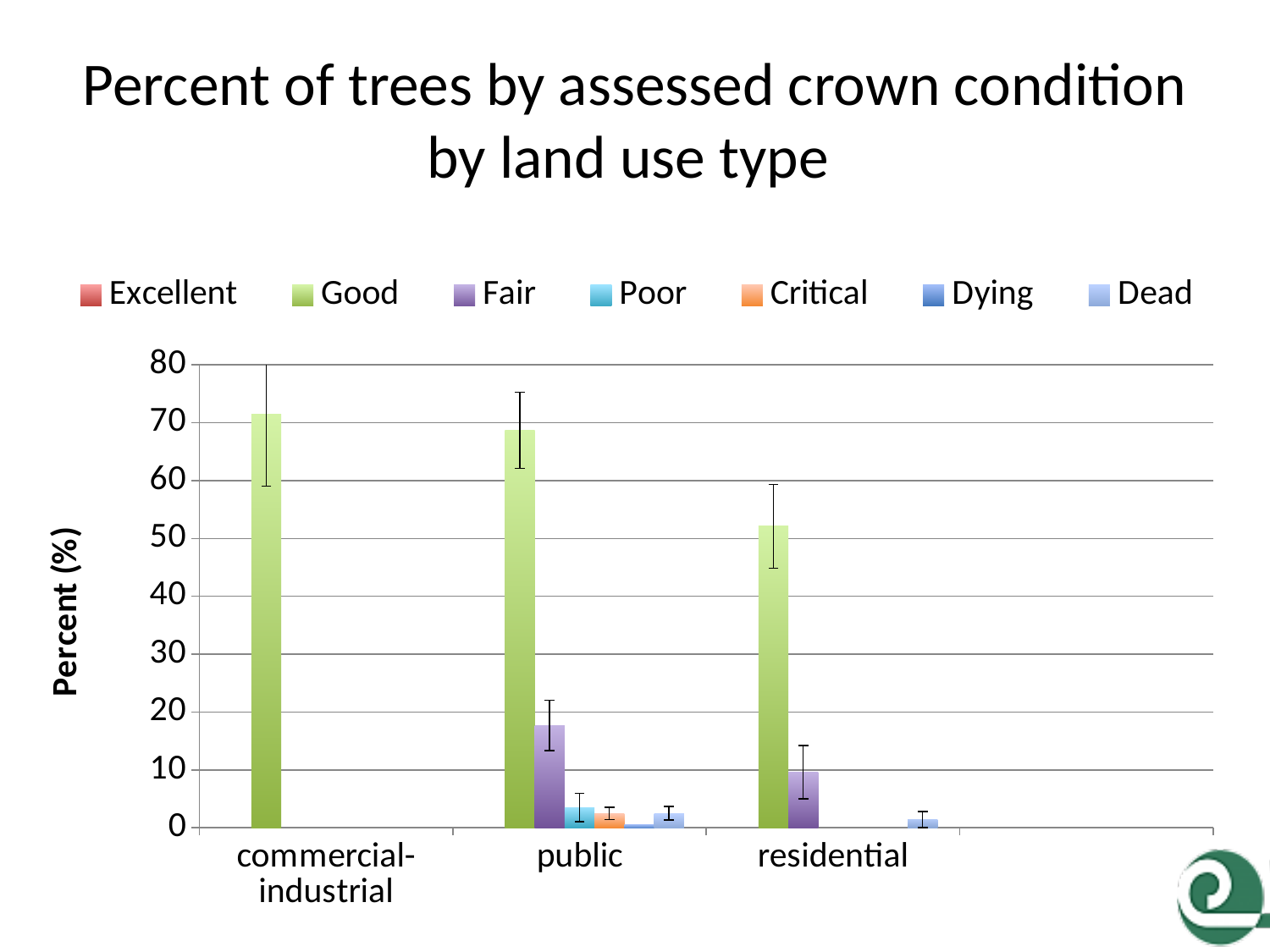
Which land use type has the lowest value for Good? residential Is the value for Fair in public greater or less than 10? greater Do the Good values rise or fall from commercial-industrial to residential? fall Is the value for Fair in residential greater or less than 20? less How many series does the legend list? 7 Is the value for Good in public greater or less than 60? greater What kind of chart is shown on the slide? bar chart In residential, which is larger, Good or Fair? Good What is the label of the y axis? Percent (%) How many land use types are shown on the x axis? 3 Which is larger, the Fair value for public or the Fair value for residential? public